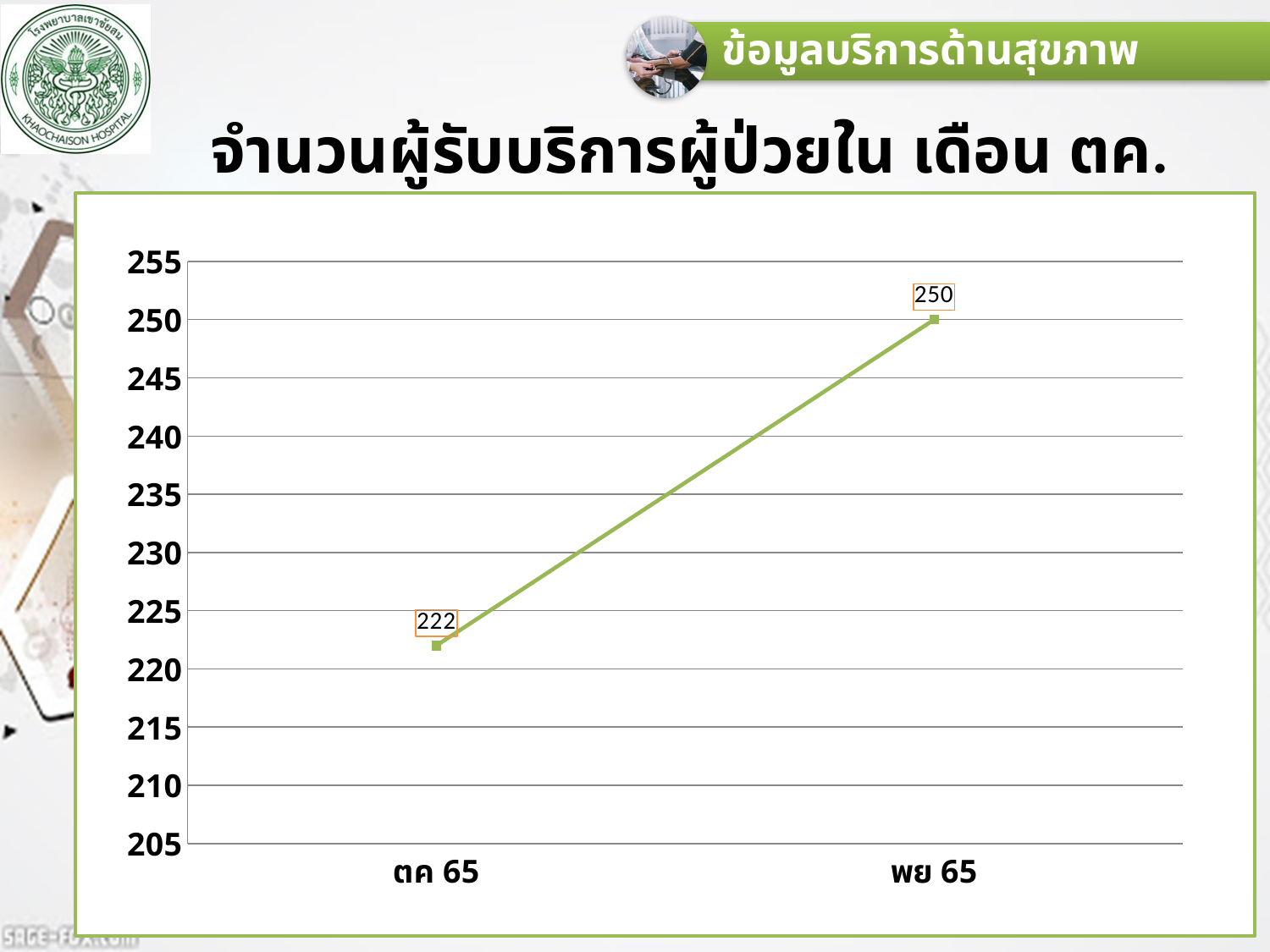
Is the value for ตค 65 greater or less than 230? less What is the value for พย 65? 250 What is the title of the chart on the slide? จำนวนผู้รับบริการผู้ป่วยใน เดือน ตค. Which is larger, the value for ตค 65 or the value for พย 65? พย 65 What kind of chart is shown on the slide? line chart What is the value for ตค 65? 222 What is the difference between the values for พย 65 and ตค 65? 28 Is the value for พย 65 greater or less than 240? greater Which category has the lowest value? ตค 65 Which category has the highest value? พย 65 How many data points are plotted on the chart? 2 Do the values rise or fall from ตค 65 to พย 65? rise